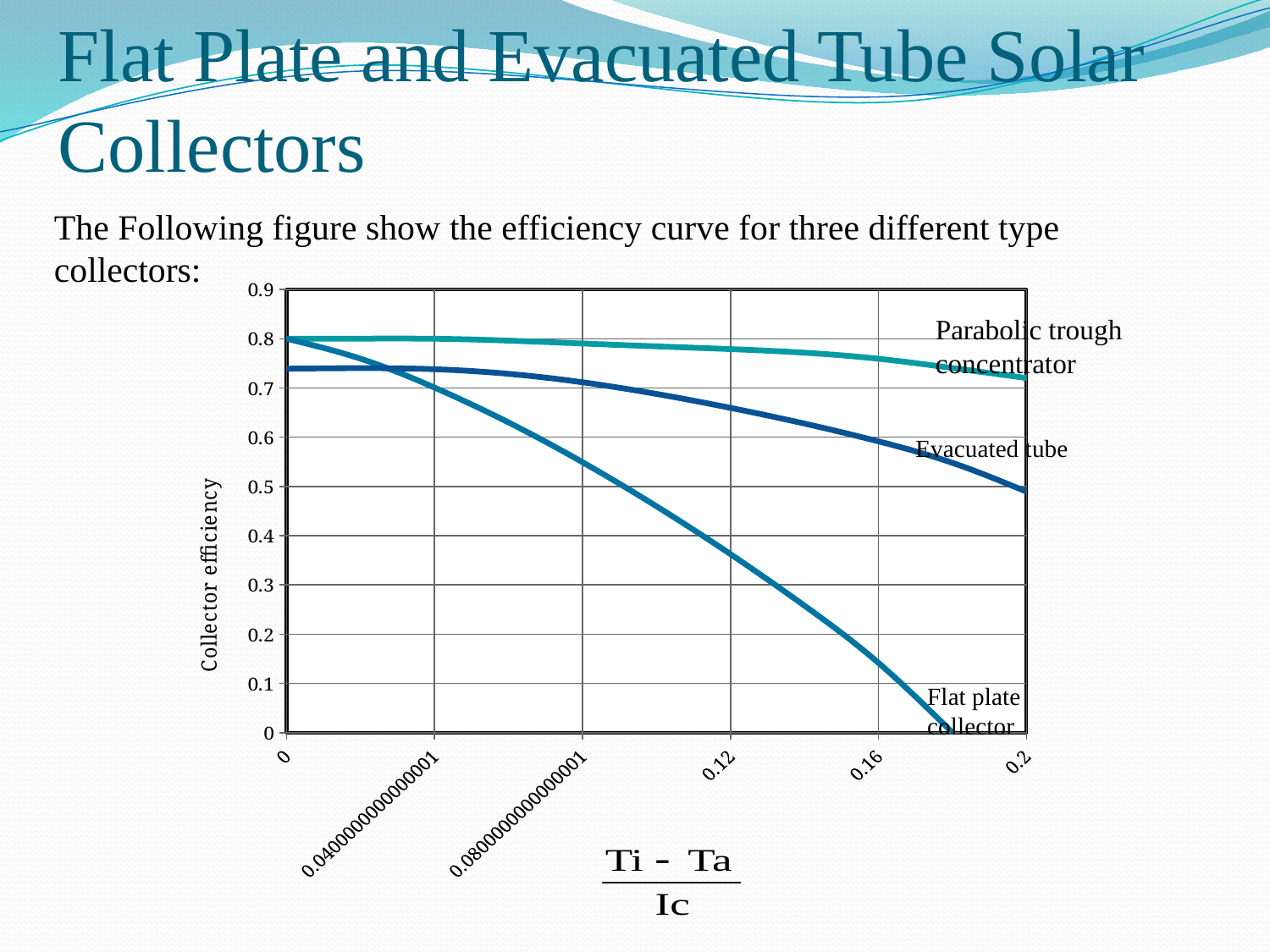
What is the title of the vertical axis of the chart? Collector efficiency Which curve has the highest collector efficiency at (Ti - Ta)/Ic = 0.2? Parabolic trough concentrator Is the efficiency of the Flat plate collector at (Ti - Ta)/Ic = 0.12 greater or less than 0.5? less Is the efficiency of the Evacuated tube at (Ti - Ta)/Ic = 0.12 greater or less than 0.6? greater Is the efficiency of the Evacuated tube at (Ti - Ta)/Ic = 0.2 greater or less than 0.4? greater What kind of chart is shown on the slide? line chart What is the collector efficiency of the Flat plate collector at (Ti - Ta)/Ic = 0? 0.8 How many collector types (curves) are plotted on the chart? 3 At (Ti - Ta)/Ic = 0.16, which has the higher efficiency: the Parabolic trough concentrator or the Flat plate collector? Parabolic trough concentrator Does the efficiency of the Flat plate collector rise or fall as (Ti - Ta)/Ic increases? fall